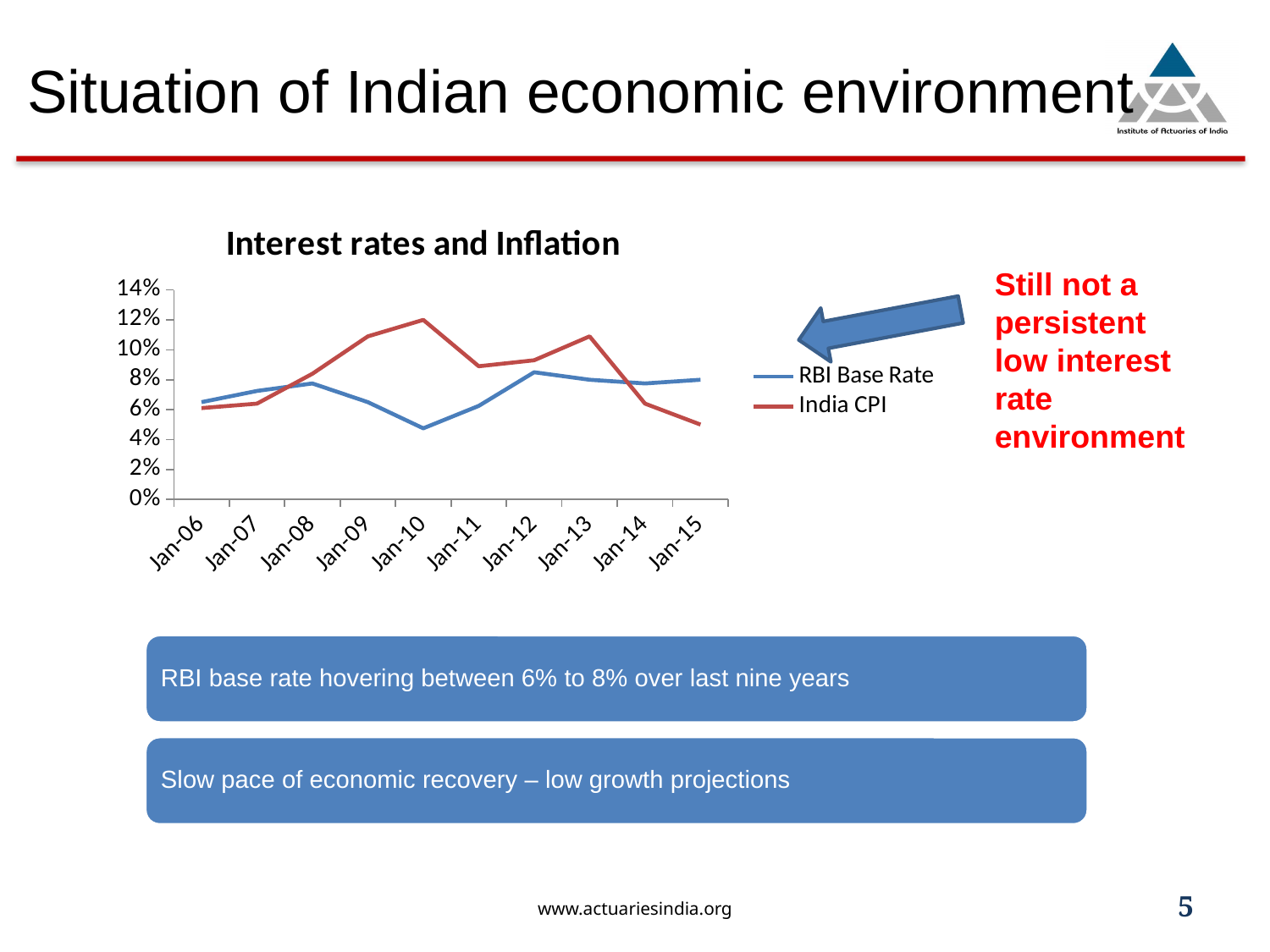
How many points are plotted along the x axis for each series in the "Interest rates and Inflation" chart? 10 At Jan-15, which series has the larger value, RBI Base Rate or India CPI? RBI Base Rate What kind of chart is shown under the title "Interest rates and Inflation"? Line chart Is the value of RBI Base Rate at Jan-10 greater or less than 6%? less How many series does the legend of the "Interest rates and Inflation" chart list? 2 Which series in the chart is drawn in red? India CPI In which year does the RBI Base Rate series reach its lowest value? Jan-10 At Jan-13, which series has the larger value, RBI Base Rate or India CPI? India CPI Is the value of India CPI at Jan-10 greater or less than 10%? greater Does the India CPI series rise or fall between Jan-13 and Jan-15? Fall In which year does the India CPI series reach its highest value? Jan-10 What is the title of the chart on the slide? Interest rates and Inflation